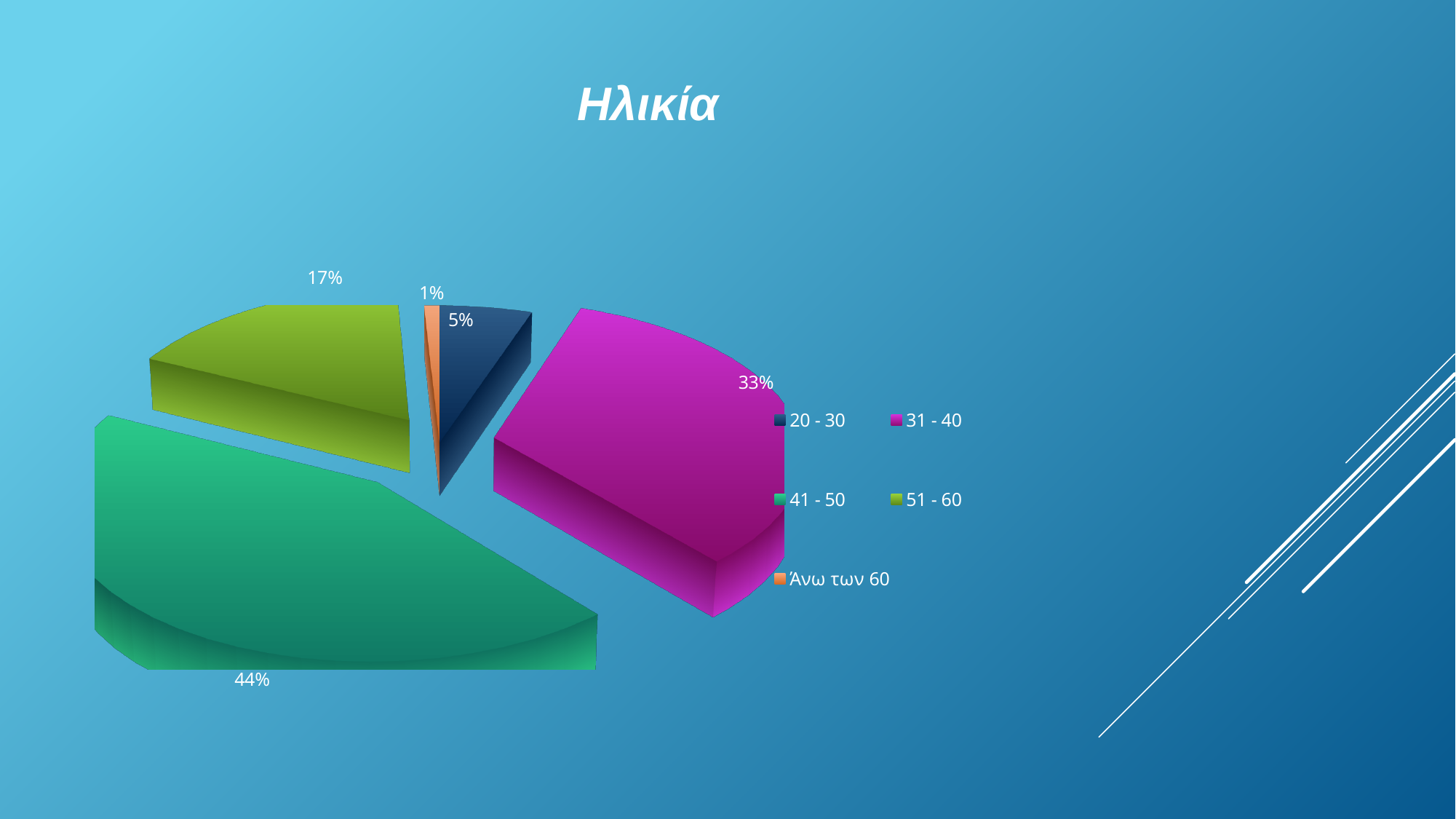
Which age group has the smallest share of the pie? Άνω των 60 What is the difference in percentage points between the 41 - 50 and 31 - 40 slices? 11 What percentage does the 31 - 40 slice represent? 33% What percentage does the 20 - 30 slice represent? 5% How many categories does the legend list? 5 What percentage does the 51 - 60 slice represent? 17% Which slice is larger, 51 - 60 or 20 - 30? 51 - 60 Which age group has the largest share of the pie? 41 - 50 What kind of chart is shown on the slide? pie chart What percentage does the 41 - 50 slice represent? 44% What percentage does the Άνω των 60 slice represent? 1% What is the title of the chart? Ηλικία